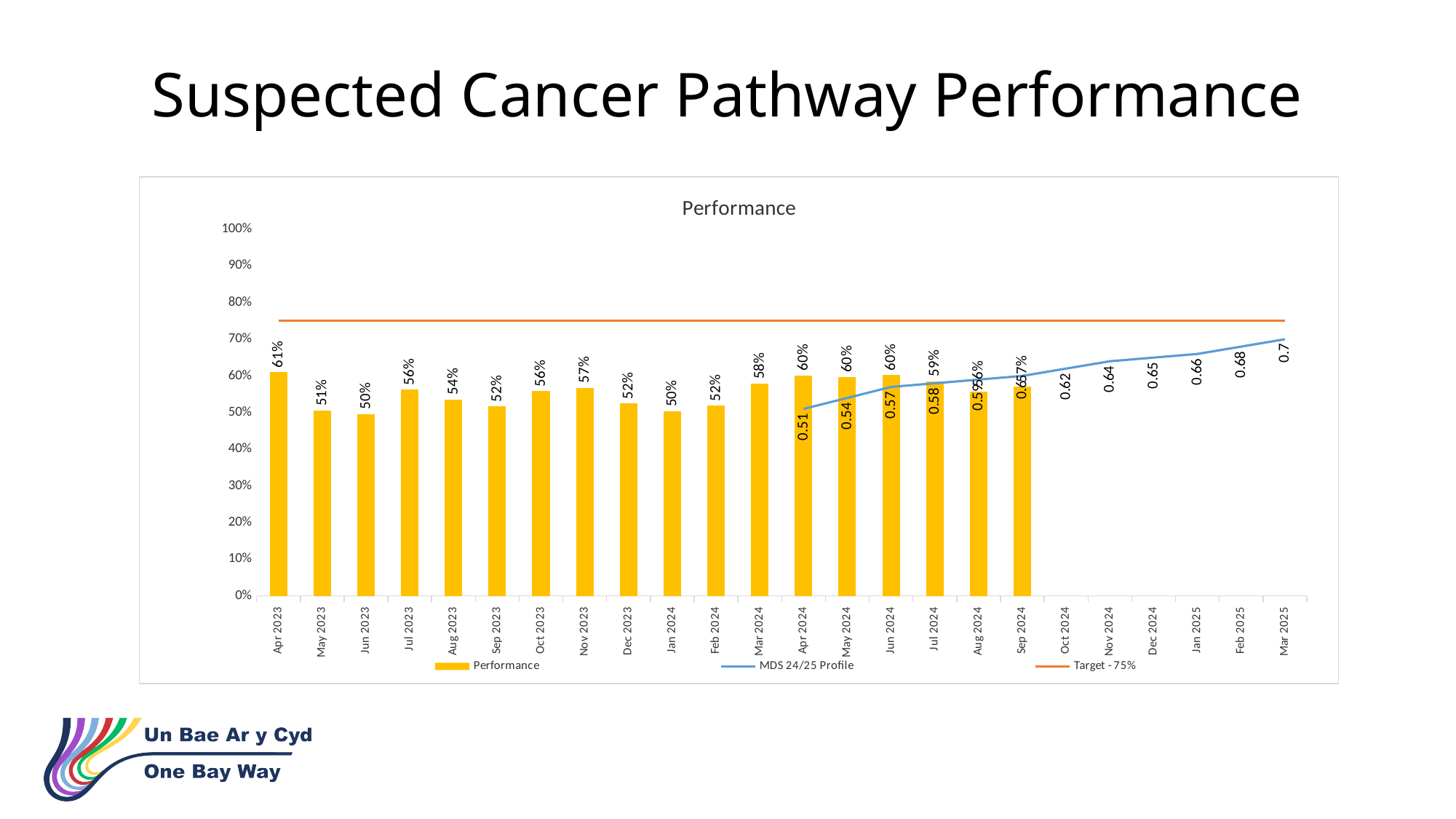
What is the Performance value for Apr 2023? 61% What is the MDS 24/25 Profile value for Mar 2025? 0.7 How many series does the legend list? 3 What is the difference between the Performance values for Apr 2023 and May 2023? 10 percentage points What is the Performance value for Jul 2024? 59% Which month has the highest Performance bar? Apr 2023 How many Performance bars are plotted on the chart? 18 What is the MDS 24/25 Profile value for Oct 2024? 0.62 What is the Performance value for Mar 2024? 58% Which has the higher Performance value, Nov 2023 or Dec 2023? Nov 2023 Does the MDS 24/25 Profile line rise or fall from Apr 2024 to Mar 2025? rises What target value is named in the legend? 75%